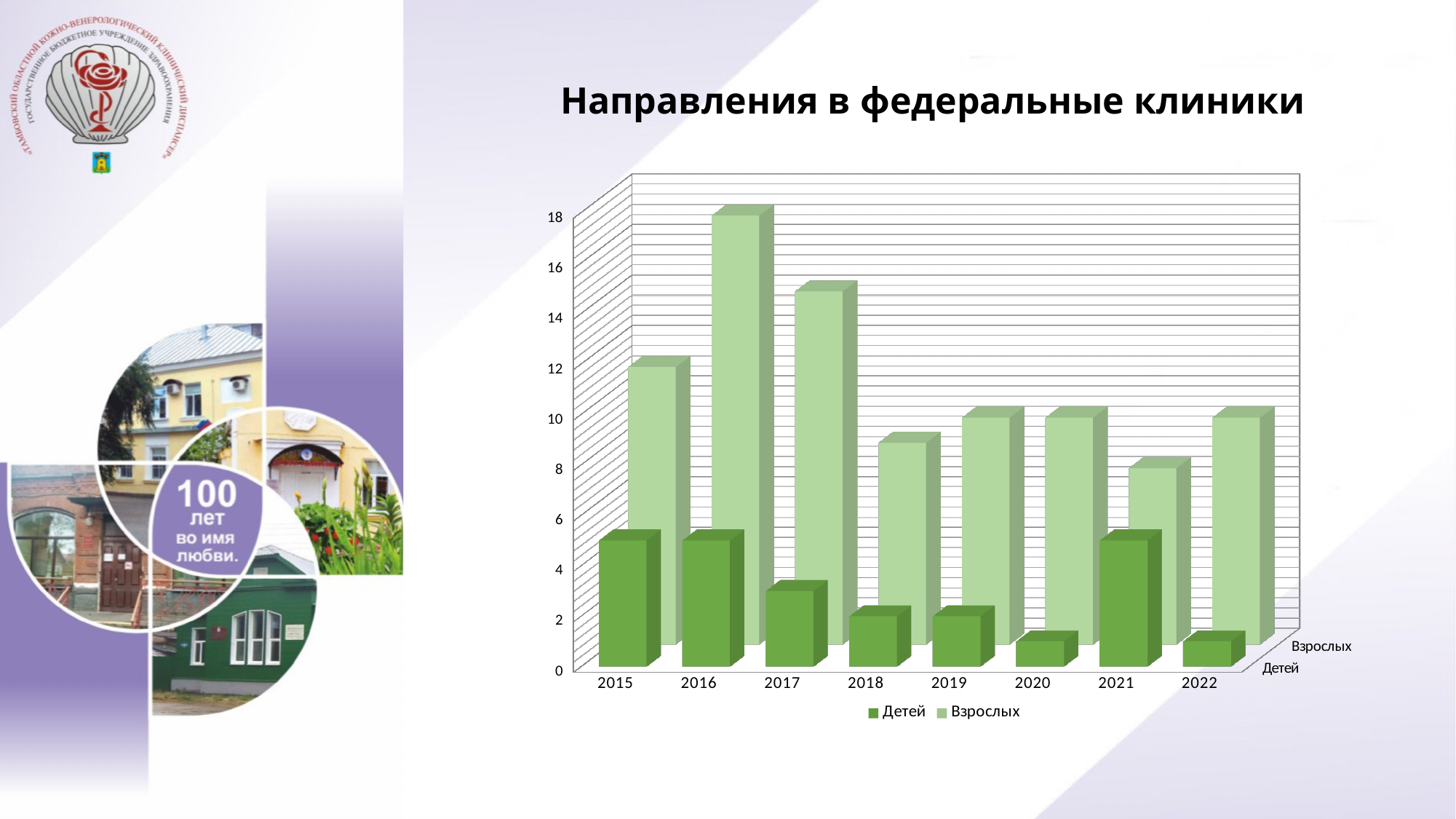
Is the value for Взрослых in 2018 greater or less than 10? less Is the value for Детей in 2015 greater or less than 4? greater Do the values for Детей rise or fall from 2017 to 2020? fall How many years are shown on the x axis? 8 What is the title of the chart? Направления в федеральные клиники How many series does the legend list? 2 In which year is the value for Взрослых the highest? 2016 What type of chart is shown on the slide? Bar chart Which is larger: the value for Взрослых in 2016 or in 2017? 2016